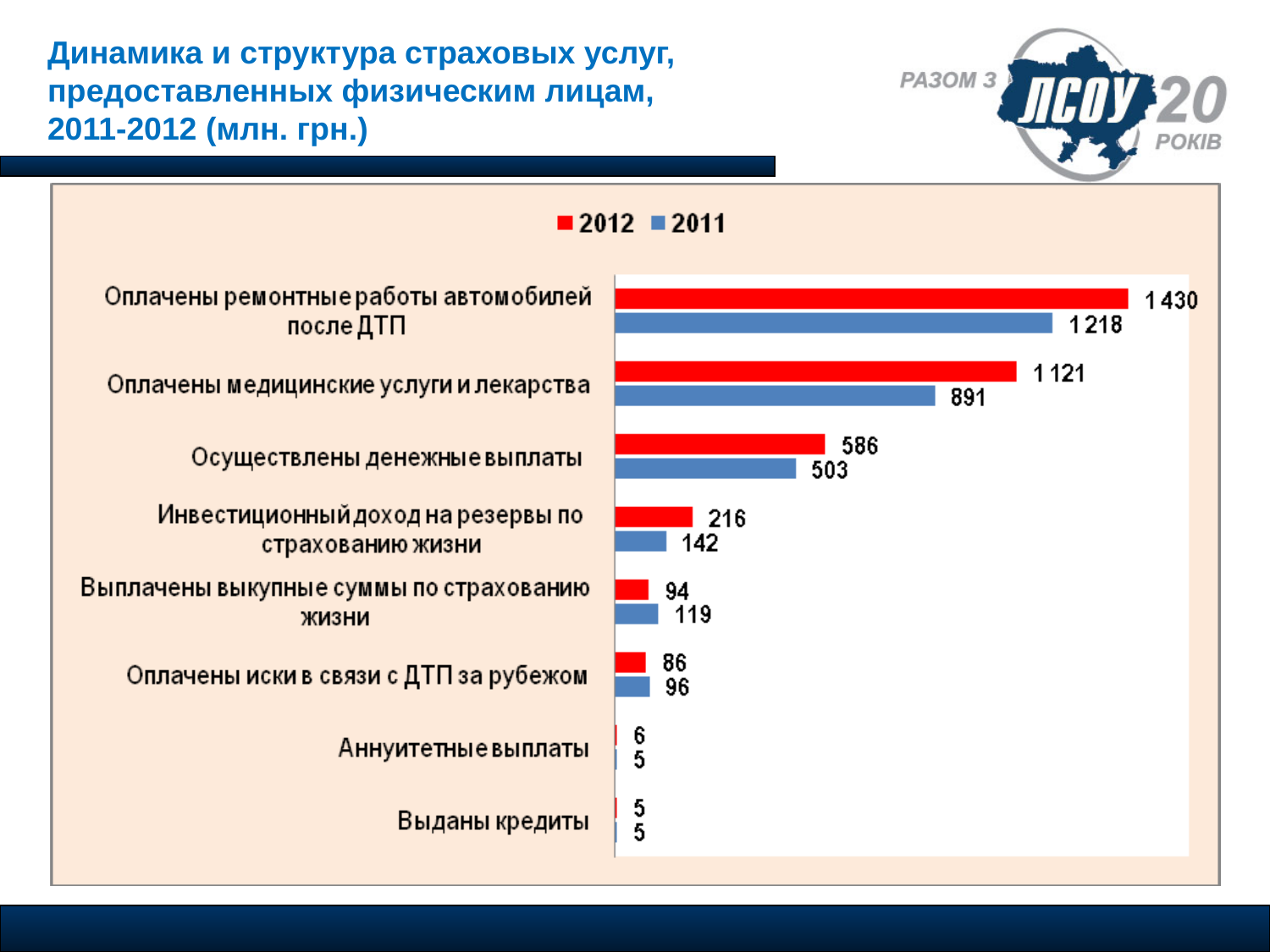
What is the difference between the 2012 and 2011 values for "Оплачены медицинские услуги и лекарства"? 230 Which colour represents the 2012 series in the chart? Red For "Выплачены выкупные суммы по страхованию жизни", which year has the larger value, 2012 or 2011? 2011 What is the 2012 value for "Инвестиционный доход на резервы по страхованию жизни"? 216 What is the 2012 value for "Оплачены ремонтные работы автомобилей после ДТП"? 1 430 How many categories are shown in the chart? 8 How many series does the legend list? 2 Which category has the highest 2012 value? Оплачены ремонтные работы автомобилей после ДТП What kind of chart is shown on the slide? Bar chart Which category has the lowest 2011 value? Аннуитетные выплаты and Выданы кредиты (both 5) What is the 2011 value for "Оплачены медицинские услуги и лекарства"? 891 What is the difference between the 2012 and 2011 values for "Осуществлены денежные выплаты"? 83